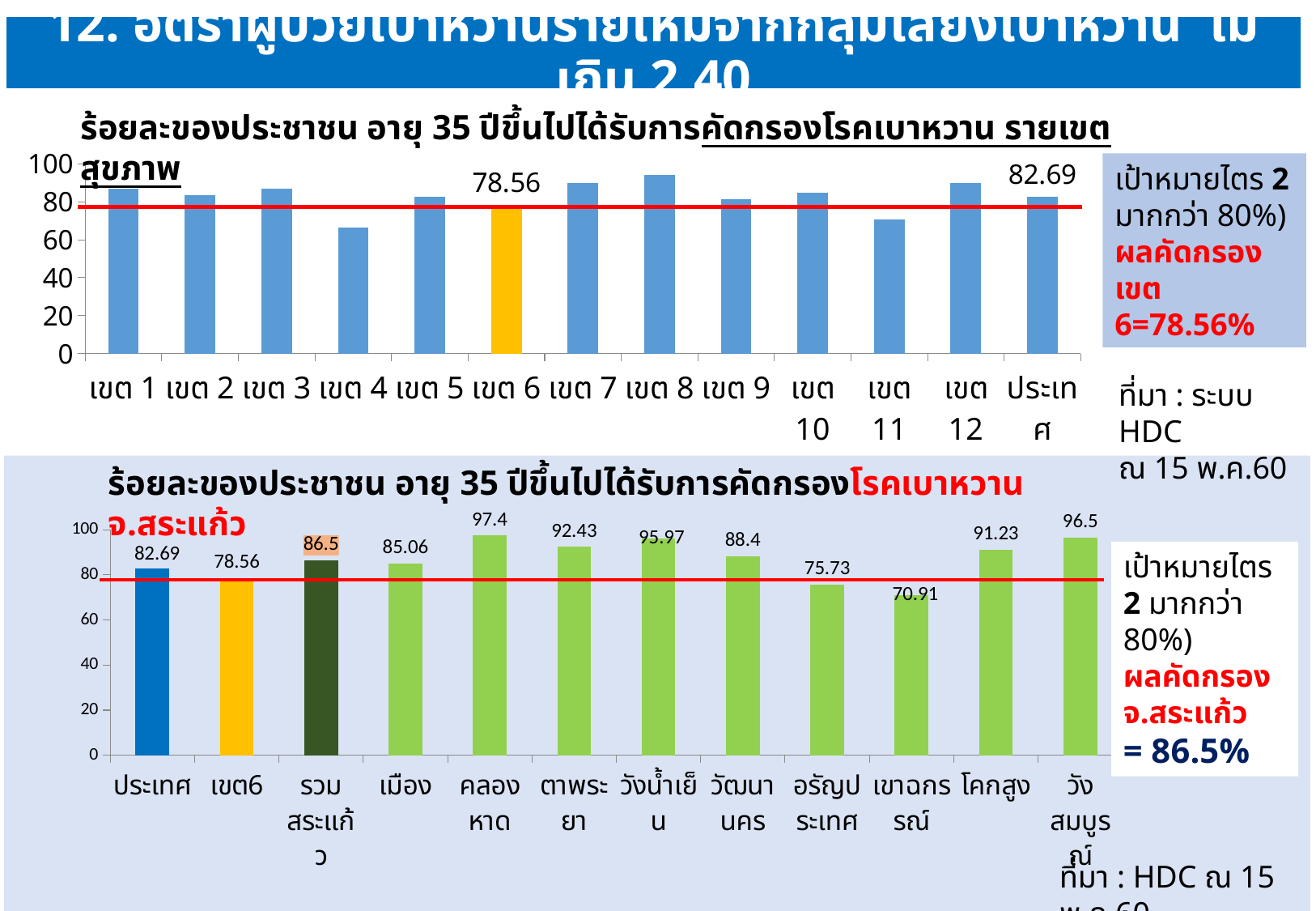
What type of chart is the bottom chart? bar chart In the bottom chart, what is the difference between the values for วังสมบูรณ์ and อรัญประเทศ? 20.77 In the bottom chart, what is the value for รวมสระแก้ว? 86.5 In the top chart, what is the value for เขต 6? 78.56 In the bottom chart, what is the value for คลองหาด? 97.4 In the bottom chart, which category has the lowest value? เขาฉกรรณ์ In the top chart, is the value for เขต 11 greater or less than 80? less In the bottom chart, which is larger, the value for ตาพระยา or the value for โคกสูง? ตาพระยา In the top chart, which category has the highest bar? เขต 8 In the top chart, which category has the lowest bar? เขต 4 In the top chart, how many categories are shown on the x axis? 13 In the top chart, what is the value for ประเทศ? 82.69